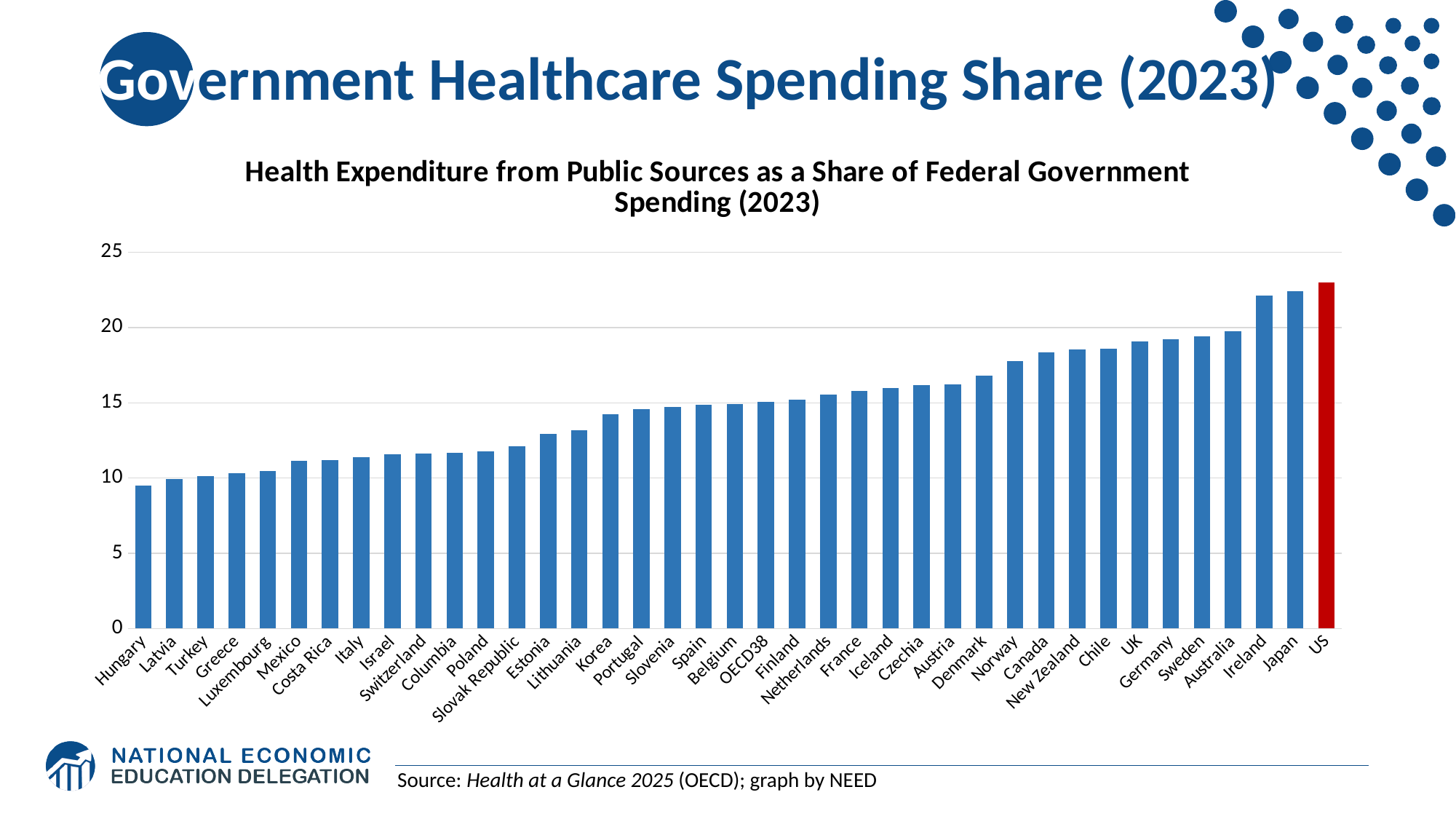
Is the value for Hungary greater or less than 10? less Which country has the highest health expenditure share in the chart? US Is the value for the US greater or less than 20? greater Which country's bar is coloured red instead of blue? US Is the value for Norway greater or less than 15? greater Which country has the lowest health expenditure share in the chart? Hungary Which has a larger value, Germany or Korea? Germany Do the bar values rise or fall moving from left to right along the x axis? Rise What kind of chart is shown on the slide? Bar chart How many bars (countries/groups) are plotted in the chart? 39 Which has a larger value, Latvia or Japan? Japan